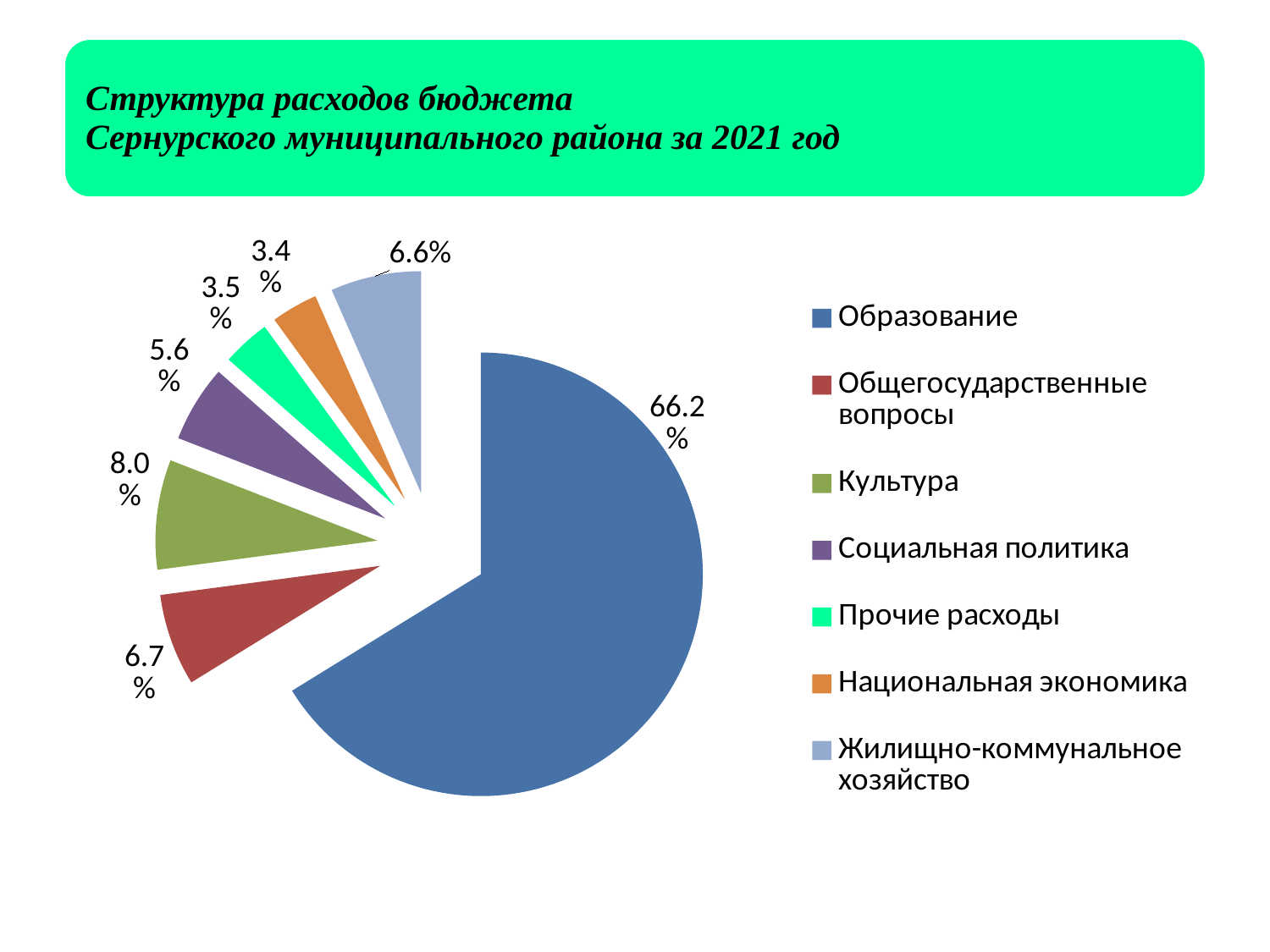
What is the value shown for Жилищно-коммунальное хозяйство? 6.6% Which category has the smallest share of the pie? Национальная экономика What share of budget expenditure does Образование account for? 66.2% How many categories does the legend list? 7 What kind of chart is shown on the slide? pie chart What is the title of the slide? Структура расходов бюджета Сернурского муниципального района за 2021 год What is the value shown for Социальная политика? 5.6% Which category is shown in orange? Национальная экономика Which category has the largest share of the pie? Образование Which is larger, the share for Общегосударственные вопросы or the share for Социальная политика? Общегосударственные вопросы What is the value shown for Культура? 8.0% What is the difference between the shares of Культура and Общегосударственные вопросы? 1.3%